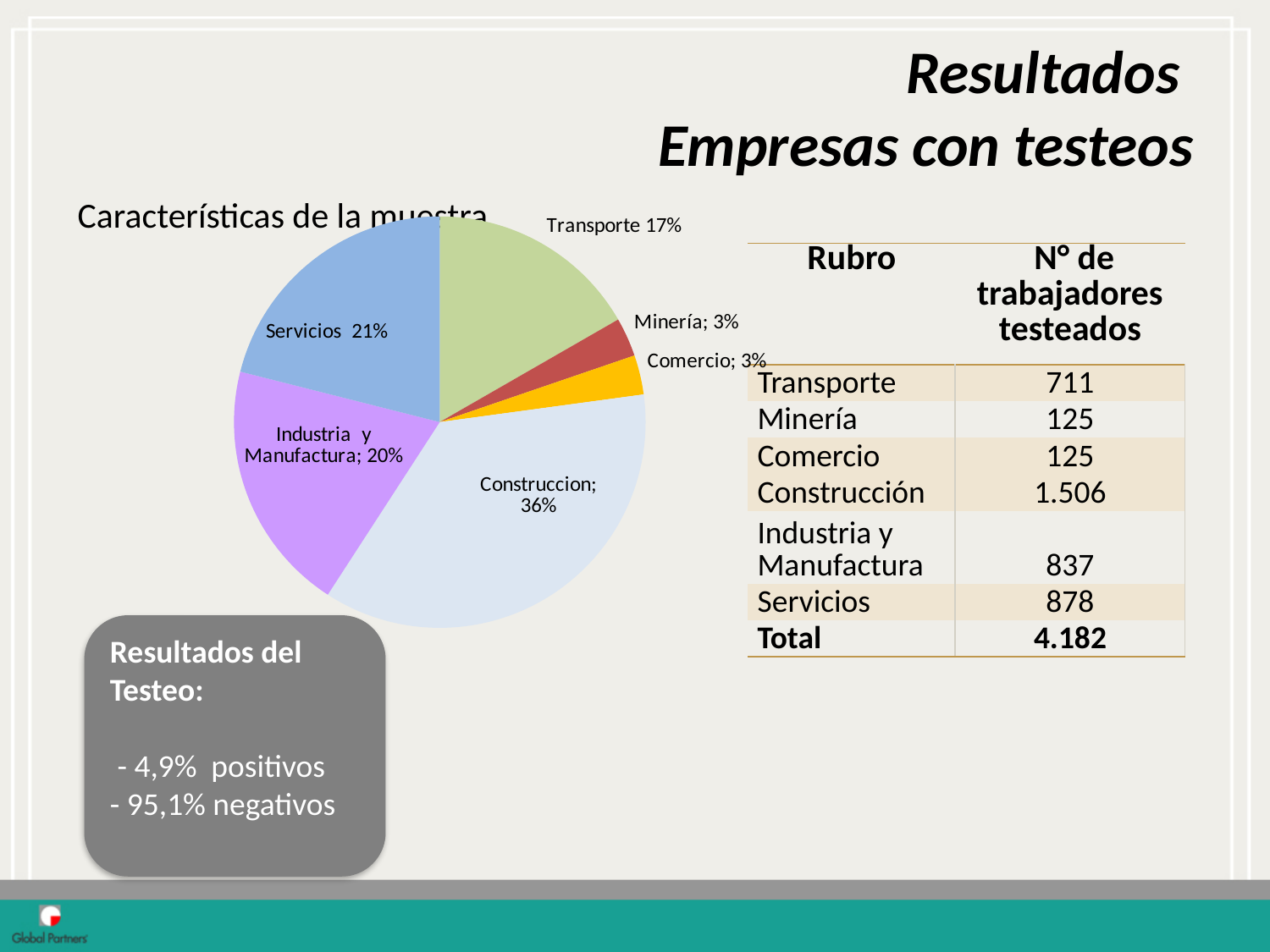
What is the difference in percentage points between the Construccion slice and the Servicios slice? 15 What share of the pie does Minería represent? 3% What colour is the Construccion slice of the pie chart? light blue Which category has the largest slice of the pie chart? Construccion Which slice is larger, Transporte or Industria y Manufactura? Industria y Manufactura How many slices does the pie chart have? 6 What kind of chart is shown on the slide? pie chart What is the difference in percentage points between the Transporte slice and the Comercio slice? 14 What share of the pie does Industria y Manufactura represent? 20% What share of the pie does Transporte represent? 17%